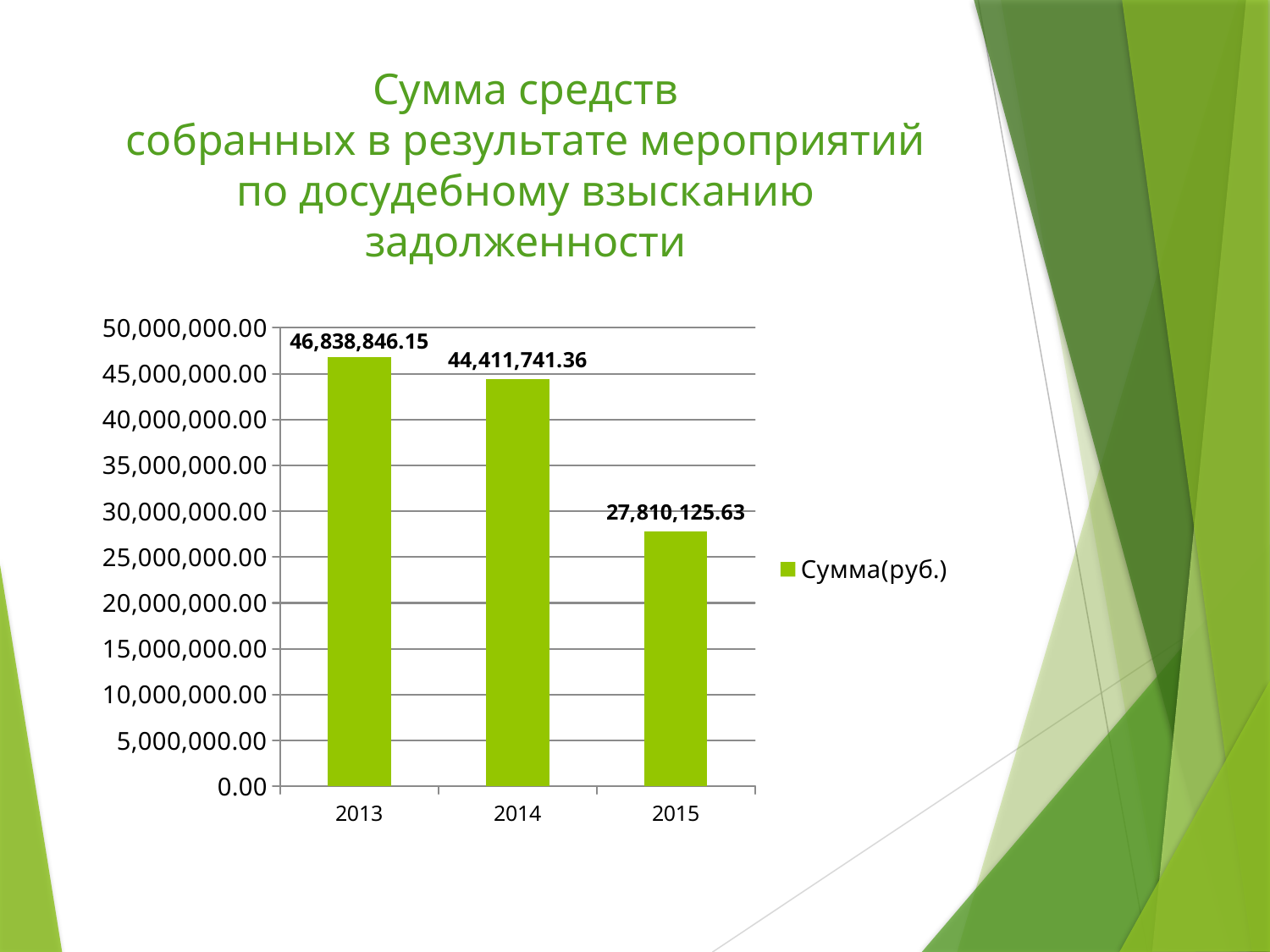
What is the value for 2014? 44,411,741.36 Which year has the lowest value? 2015 What is the value for 2013? 46,838,846.15 What is the value for 2015? 27,810,125.63 Which is larger, the value for 2014 or the value for 2015? 2014 What is the difference between the values for 2014 and 2015? 16,601,615.73 What kind of chart is shown? bar chart Is the value for 2015 greater or less than 30,000,000.00? less Which year has the highest value? 2013 What is the difference between the values for 2013 and 2014? 2,427,104.79 How many years are shown on the x axis? 3 Do the values rise or fall from 2013 to 2015? fall